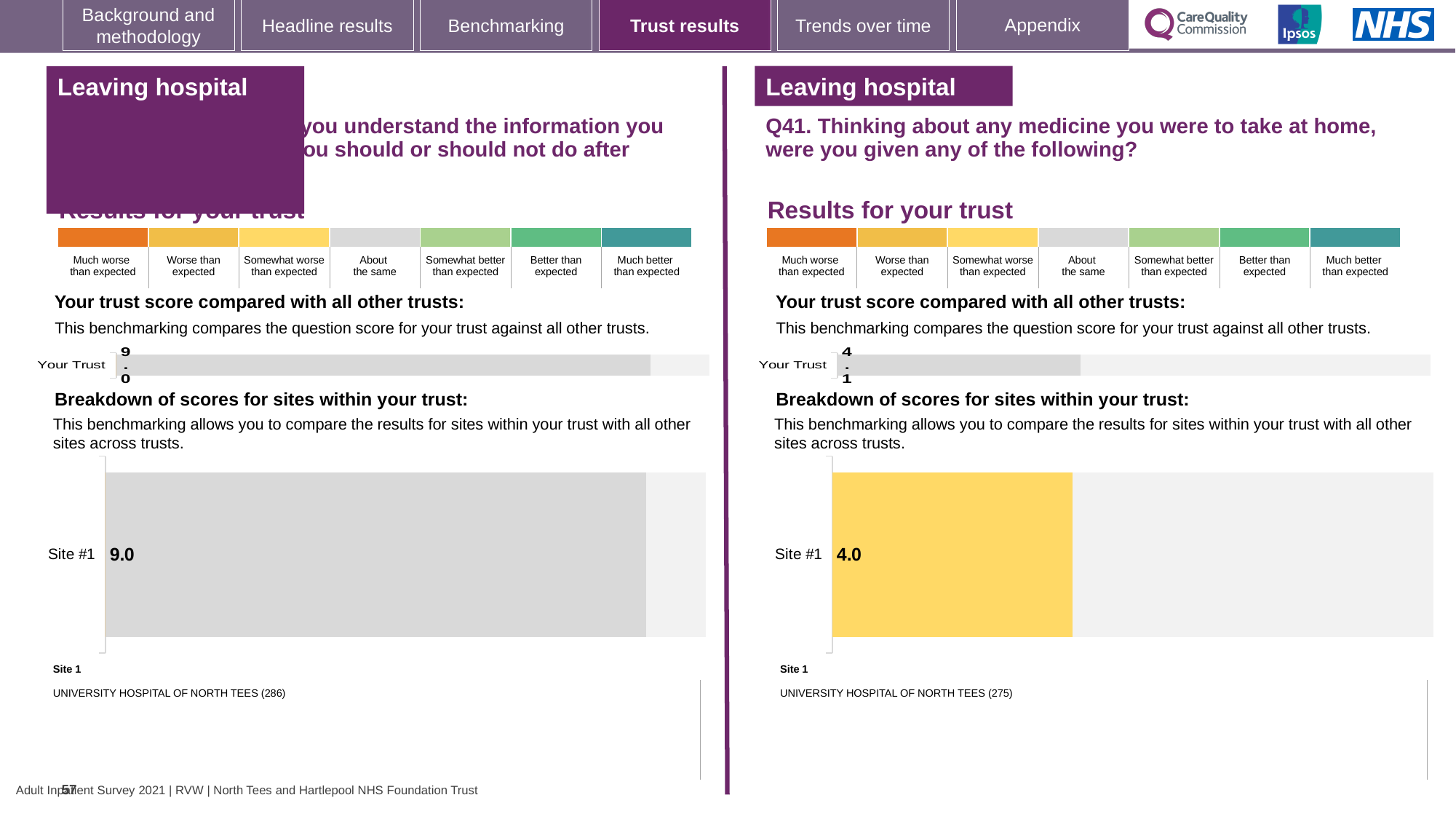
On the right chart (Q41), what is the difference between the 'Your Trust' score and the Site #1 score? 0.1 How many sites are shown in the breakdown of scores on the right chart (Q41)? 1 On the right chart (Q41), what is the score shown for Site #1 in the breakdown of scores for sites within your trust? 4.0 On the right chart (Q41), what colour is the Site #1 bar? Yellow What type of chart is used for the breakdown of scores for sites on the left side of the slide? Bar chart What is the difference between the Site #1 score on the left chart and the Site #1 score on the right chart (Q41)? 5.0 On the left chart, what is the 'Your Trust' score compared with all other trusts? 9.0 On the left chart, what is the score shown for Site #1 in the breakdown of scores for sites within your trust? 9.0 On the right chart (Q41), what is the 'Your Trust' score compared with all other trusts? 4.1 On the right chart (Q41), which hospital is listed as Site 1? UNIVERSITY HOSPITAL OF NORTH TEES (275) Which is larger: the Site #1 score on the left chart or the Site #1 score on the right chart (Q41)? Left chart